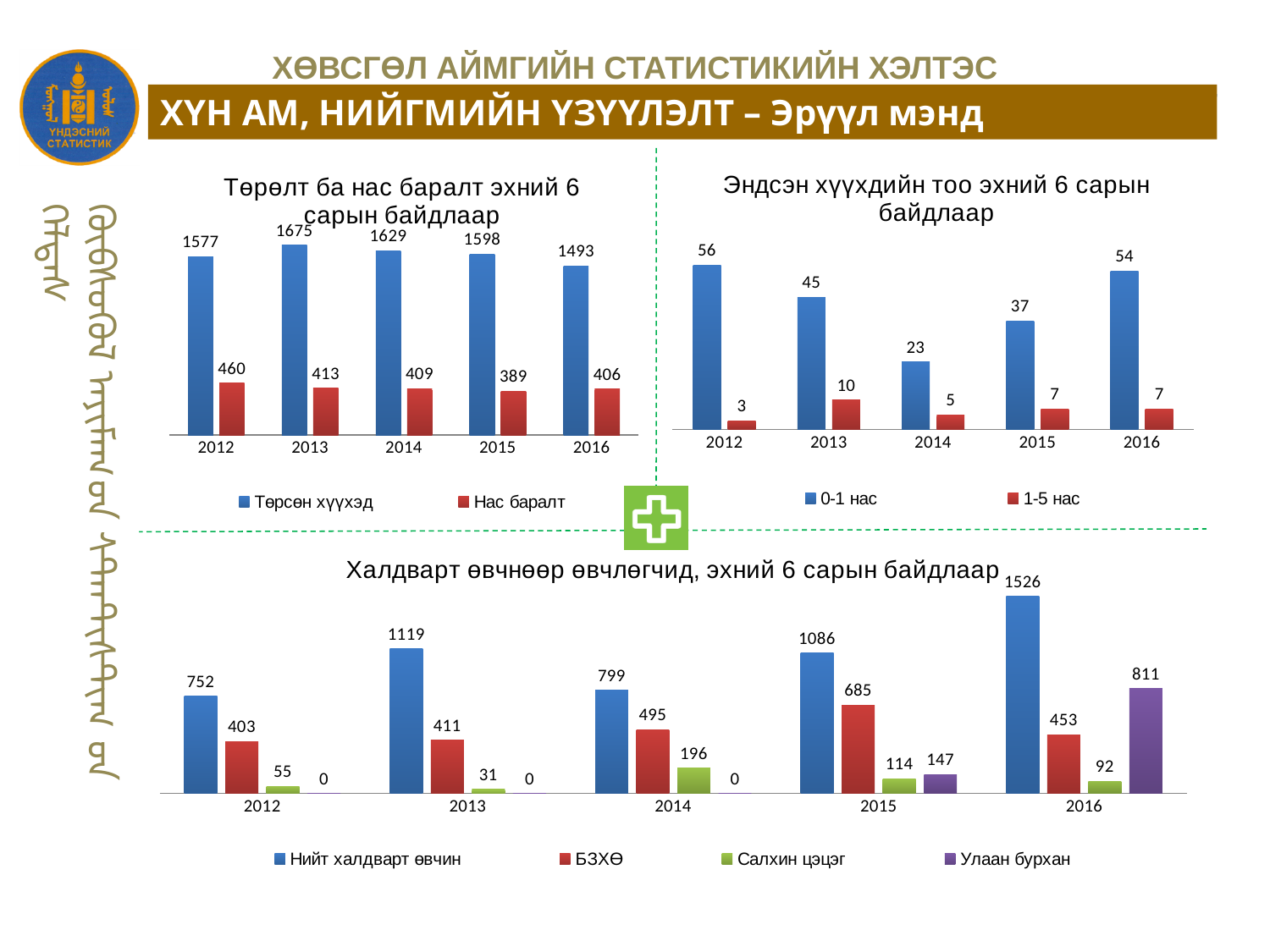
In the top-left chart 'Төрөлт ба нас баралт эхний 6 сарын байдлаар', how many series does the legend list? 2 In the bottom chart 'Халдварт өвчнөөр өвчлөгчид, эхний 6 сарын байдлаар', what is the value for Улаан бурхан in 2016? 811 In the top-left chart 'Төрөлт ба нас баралт эхний 6 сарын байдлаар', what is the difference between Төрсөн хүүхэд and Нас баралт in 2016? 1087 In the top-left chart 'Төрөлт ба нас баралт эхний 6 сарын байдлаар', what is the value for Төрсөн хүүхэд in 2013? 1675 In the top-left chart 'Төрөлт ба нас баралт эхний 6 сарын байдлаар', which year has the lowest value for Нас баралт? 2015 In the top-right chart 'Эндсэн хүүхдийн тоо эхний 6 сарын байдлаар', what is the value for 0-1 нас in 2014? 23 In the top-right chart 'Эндсэн хүүхдийн тоо эхний 6 сарын байдлаар', which is larger: 1-5 нас in 2013 or 1-5 нас in 2015? 2013 In the bottom chart 'Халдварт өвчнөөр өвчлөгчид, эхний 6 сарын байдлаар', which year has the highest value for БЗХӨ? 2015 In the top-right chart 'Эндсэн хүүхдийн тоо эхний 6 сарын байдлаар', which year has the highest value for 0-1 нас? 2012 In the top-right chart 'Эндсэн хүүхдийн тоо эхний 6 сарын байдлаар', how many years are shown on the x axis? 5 What type of chart is the bottom chart 'Халдварт өвчнөөр өвчлөгчид, эхний 6 сарын байдлаар'? Bar chart In the bottom chart 'Халдварт өвчнөөр өвчлөгчид, эхний 6 сарын байдлаар', what is the difference between Нийт халдварт өвчин in 2016 and in 2015? 440